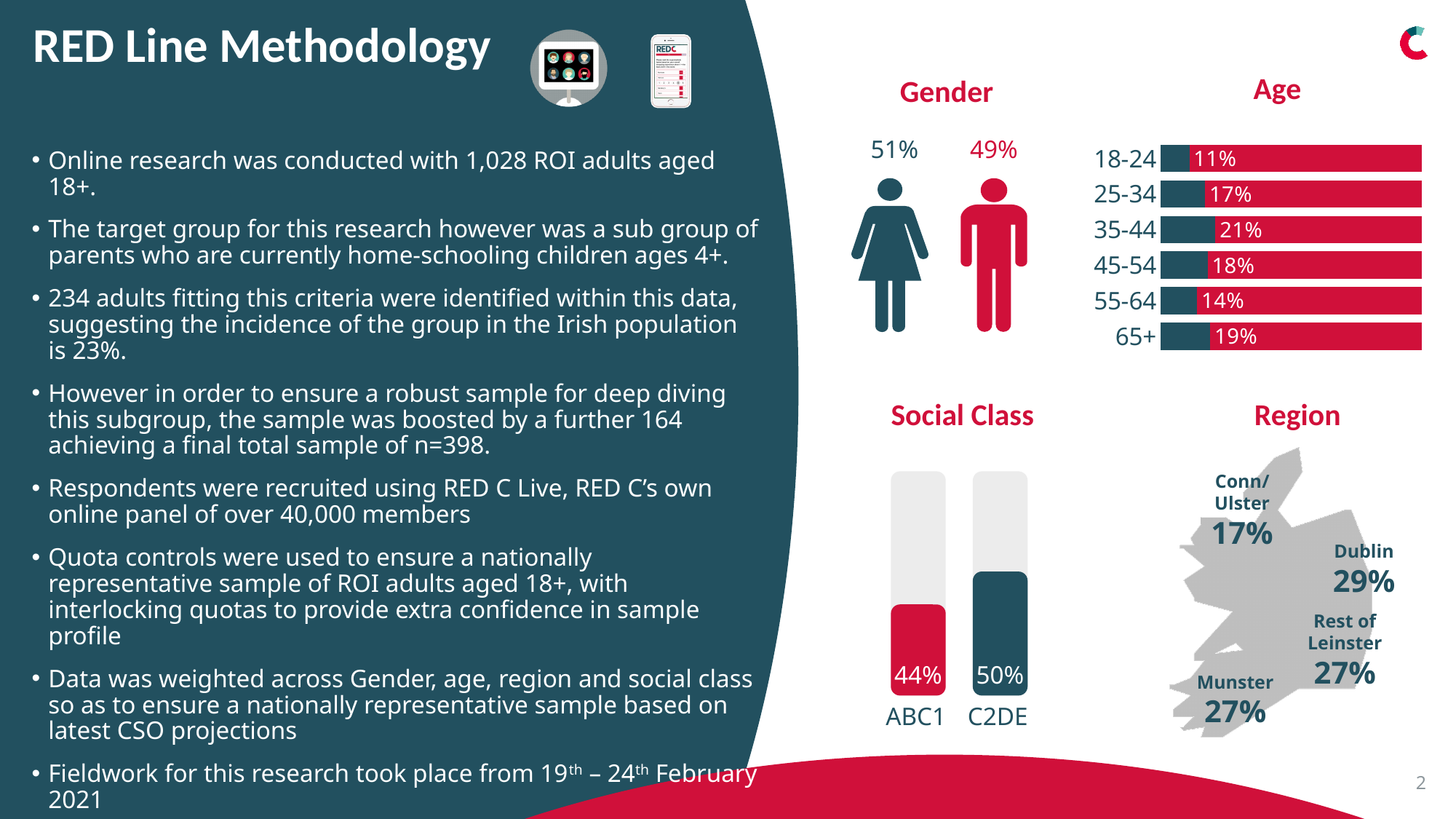
In the Social Class chart, what is the difference between C2DE and ABC1? 6 percentage points In the Social Class chart, what percentage is shown for C2DE? 50% In the Age chart, which is larger: the value for 25-34 or the value for 45-54? 45-54 In the Gender chart, what percentage is shown for the female figure? 51% In the Age chart, what is the difference between the 65+ group and the 55-64 group? 5 percentage points In the Age chart, which age group has the lowest percentage? 18-24 In the Region chart, which region has the highest percentage? Dublin In the Age chart, what percentage is shown for the 35-44 age group? 21% In the Region chart, what percentage is shown for Conn/Ulster? 17% What kind of chart is the Age chart? Bar chart In the Age chart, how many age groups are shown? 6 In the Age chart, which age group has the highest percentage? 35-44